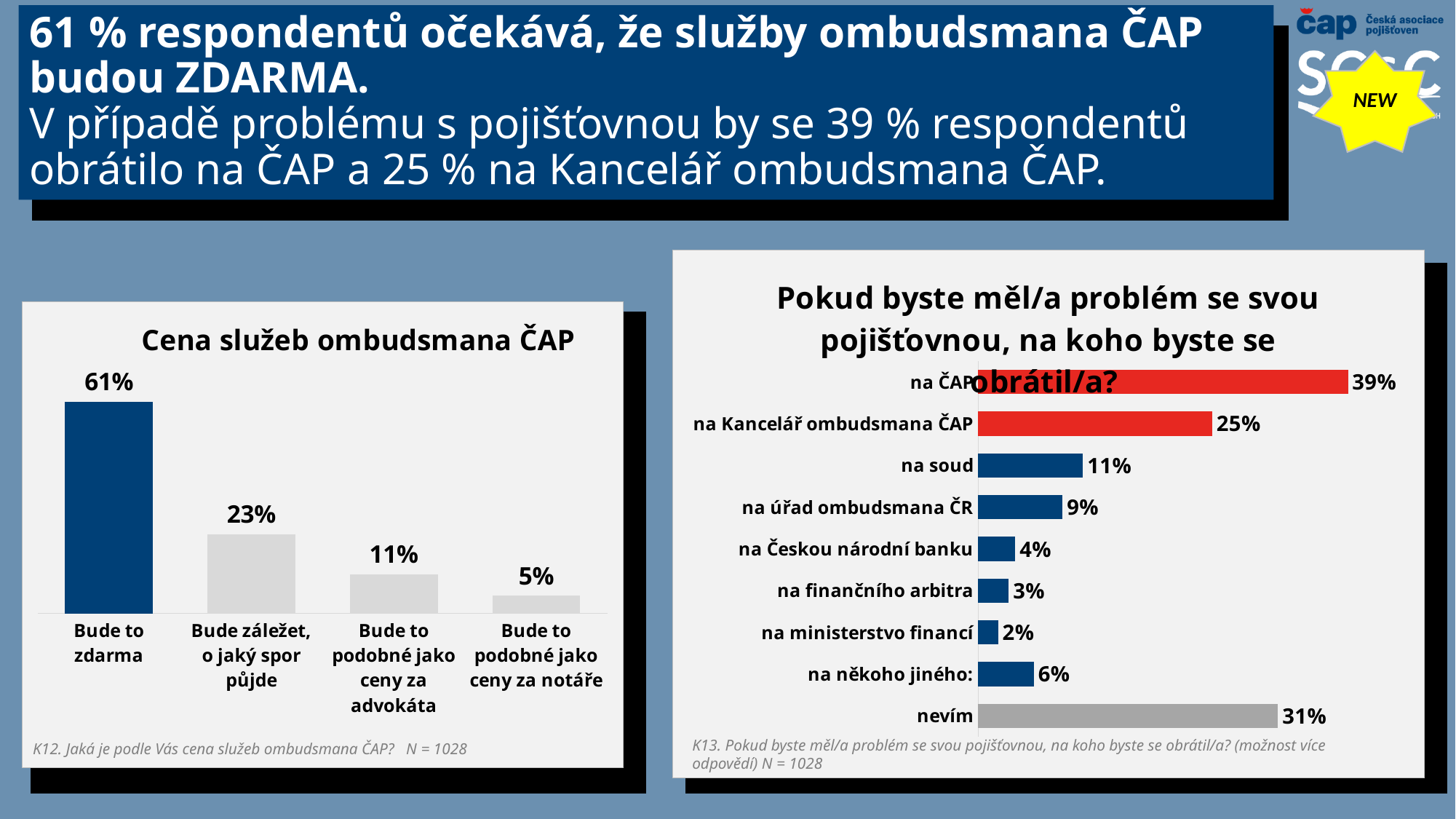
In the chart 'Cena služeb ombudsmana ČAP', what is the value for 'Bude to podobné jako ceny za notáře'? 5% In the chart 'Cena služeb ombudsmana ČAP', what is the value for 'Bude to zdarma'? 61% In the chart on the right, how many categories are shown? 9 In the chart 'Cena služeb ombudsmana ČAP', what is the difference between 'Bude to zdarma' and 'Bude záležet, o jaký spor půjde'? 38% In the chart on the right, what is the value for 'na finančního arbitra'? 3% In the chart on the right, which is larger: 'na soud' or 'na úřad ombudsmana ČR'? na soud In the chart 'Cena služeb ombudsmana ČAP', which category has the lowest value? Bude to podobné jako ceny za notáře What type of chart is 'Cena služeb ombudsmana ČAP'? bar chart In the chart on the right, what is the value for 'na Kancelář ombudsmana ČAP'? 25% In the chart on the right, which category has the lowest value? na ministerstvo financí In the chart 'Cena služeb ombudsmana ČAP', how many categories are shown? 4 In the chart on the right, which category has the highest value? na ČAP